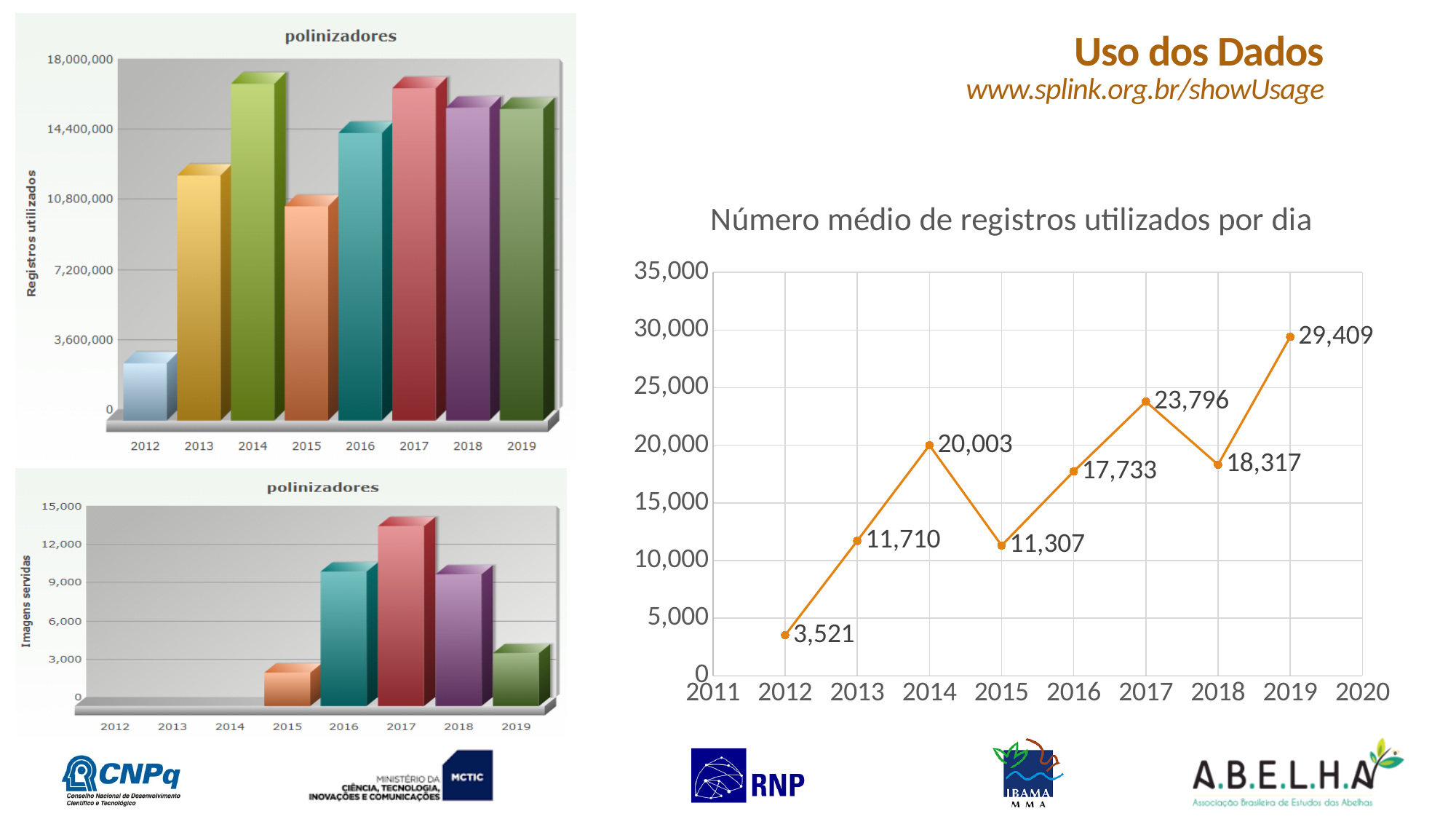
In the line chart 'Número médio de registros utilizados por dia', which is larger, the value for 2014 or the value for 2016? 2014 What type of chart is 'Número médio de registros utilizados por dia'? line chart In the top-left 'polinizadores' chart (Registros utilizados), which year has the lowest value? 2012 In the bottom-left 'polinizadores' chart (Imagens servidas), which year has the highest value? 2017 In the line chart 'Número médio de registros utilizados por dia', which year has the lowest value? 2012 In the bottom-left 'polinizadores' chart (Imagens servidas), is the value for 2015 greater or less than 3,000? less In the line chart 'Número médio de registros utilizados por dia', how many data points are plotted? 8 In the line chart 'Número médio de registros utilizados por dia', what is the value for 2019? 29,409 In the top-left 'polinizadores' chart (Registros utilizados), is the value for 2013 greater or less than 10,800,000? greater In the line chart 'Número médio de registros utilizados por dia', which year has the highest value? 2019 In the line chart 'Número médio de registros utilizados por dia', what is the value for 2015? 11,307 In the line chart 'Número médio de registros utilizados por dia', what is the difference between the values for 2017 and 2018? 5,479